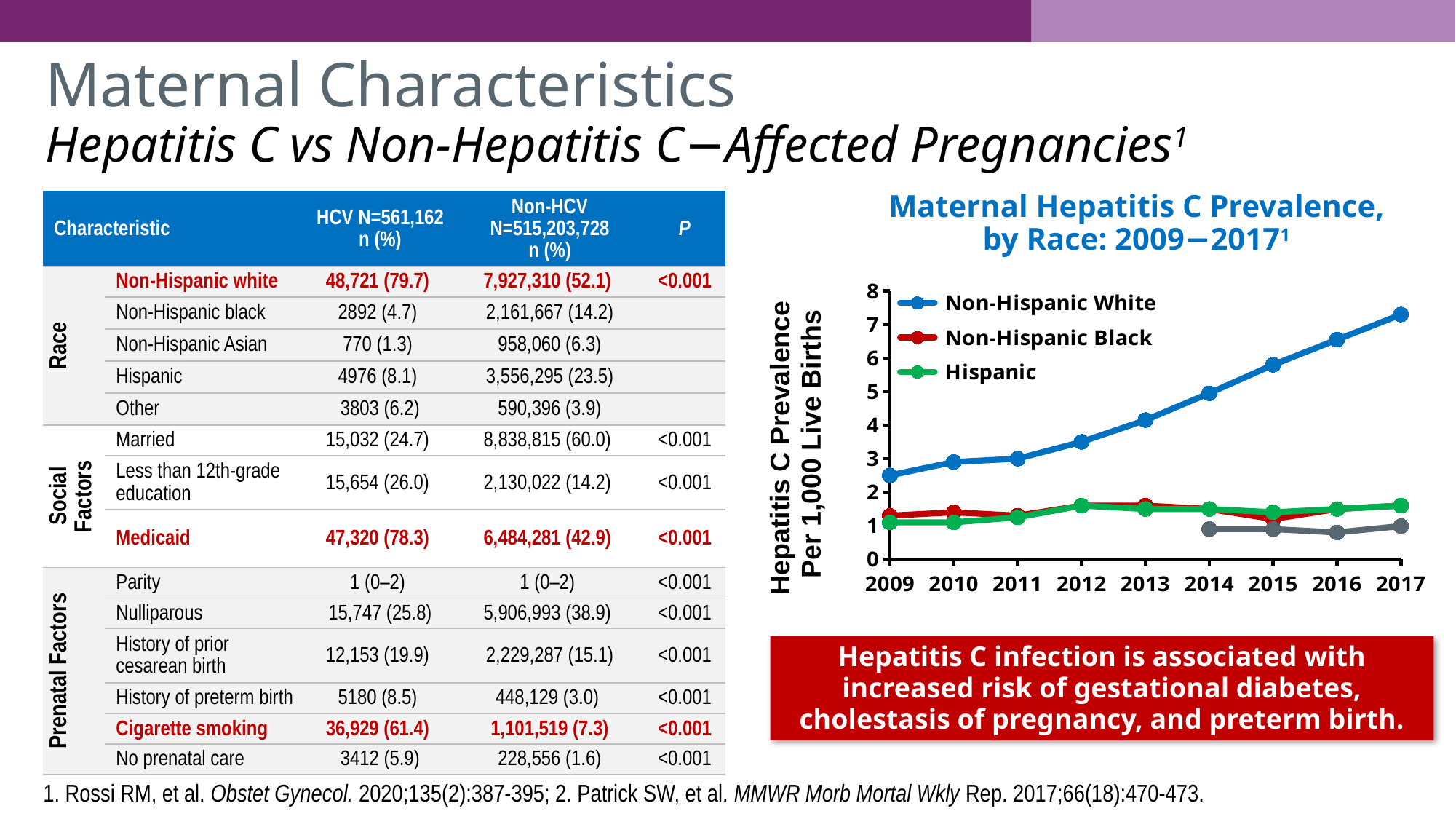
In the Maternal Hepatitis C Prevalence chart, which year has the highest value for Non-Hispanic White? 2017 In the Maternal Hepatitis C Prevalence chart, is the value for Non-Hispanic White in 2017 greater or less than 6? greater How many years are shown on the x axis of the Maternal Hepatitis C Prevalence chart? 9 In the Maternal Hepatitis C Prevalence chart, which series has the highest value in 2017? Non-Hispanic White How many series does the legend of the Maternal Hepatitis C Prevalence chart list? 3 In the Maternal Hepatitis C Prevalence chart, does the Non-Hispanic White line rise or fall from 2009 to 2017? Rise What is the y-axis label of the Maternal Hepatitis C Prevalence chart? Hepatitis C Prevalence Per 1,000 Live Births In the Maternal Hepatitis C Prevalence chart, is the value for Hispanic in 2009 greater or less than 2? less What kind of chart is shown on the right side of the slide? Line chart In the Maternal Hepatitis C Prevalence chart, which year has the lowest value for Non-Hispanic White? 2009 In the Maternal Hepatitis C Prevalence chart, which is larger in 2015: Non-Hispanic White or Non-Hispanic Black? Non-Hispanic White What is the title of the chart on the slide? Maternal Hepatitis C Prevalence, by Race: 2009−2017